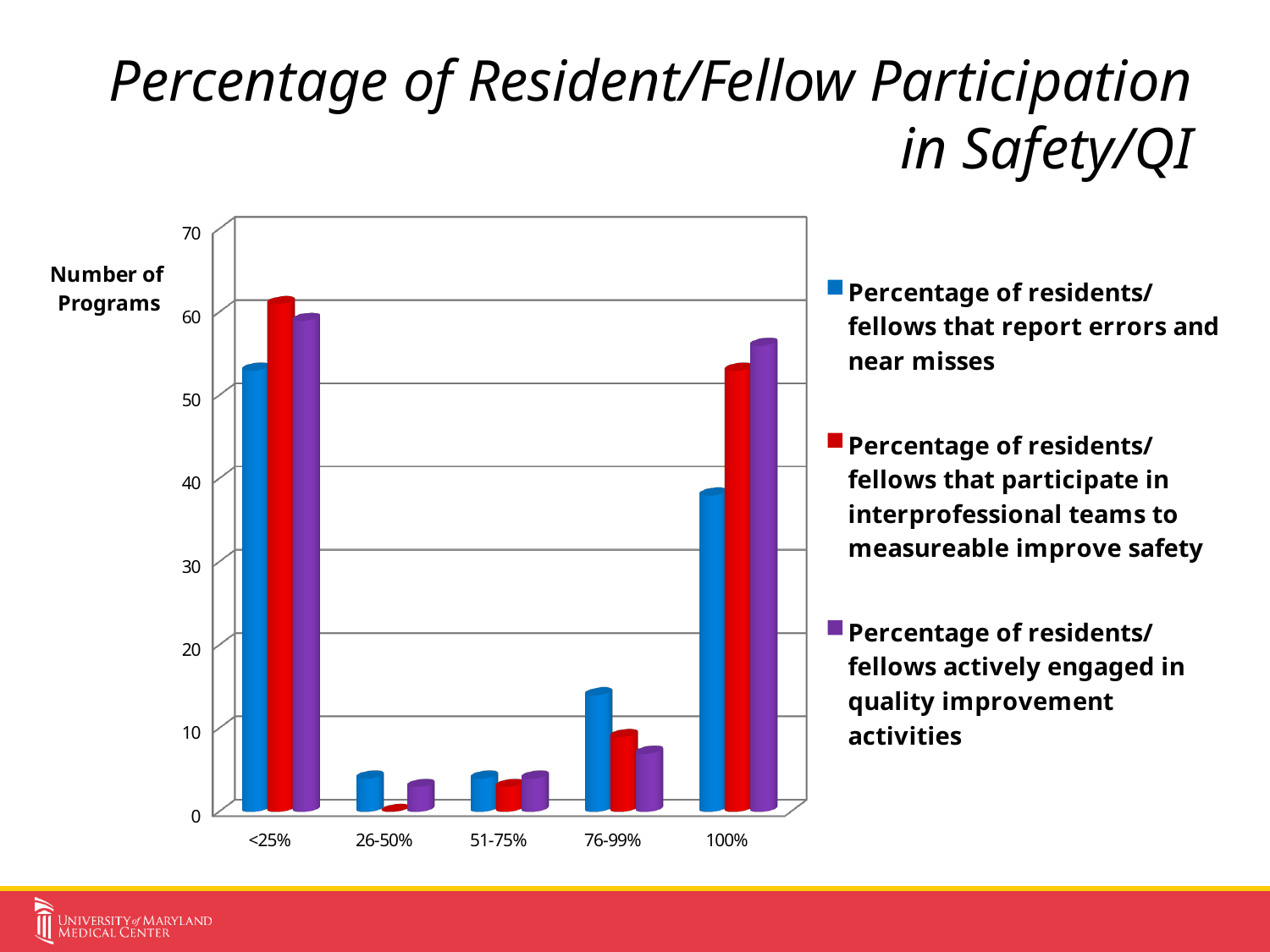
Which category has the highest value for the series 'Percentage of residents/fellows that report errors and near misses'? <25% How many series does the legend list? 3 Is the value for 'Percentage of residents/fellows actively engaged in quality improvement activities' in the 76-99% category greater or less than 10? less In the 76-99% category, which series is larger: 'Percentage of residents/fellows that report errors and near misses' or 'Percentage of residents/fellows actively engaged in quality improvement activities'? Percentage of residents/fellows that report errors and near misses Is the value for 'Percentage of residents/fellows that report errors and near misses' in the <25% category greater or less than 50? greater What kind of chart is shown on the slide? bar chart Which category has the highest value for the series 'Percentage of residents/fellows that participate in interprofessional teams to measureable improve safety'? <25% How many categories are shown on the x axis of the chart? 5 Which category has the lowest value for the series 'Percentage of residents/fellows that participate in interprofessional teams to measureable improve safety'? 26-50% In the 100% category, which series is larger: 'Percentage of residents/fellows that report errors and near misses' or 'Percentage of residents/fellows that participate in interprofessional teams to measureable improve safety'? Percentage of residents/fellows that participate in interprofessional teams to measureable improve safety What is the label of the vertical axis? Number of Programs Is the value for 'Percentage of residents/fellows that report errors and near misses' in the 100% category greater or less than 40? less